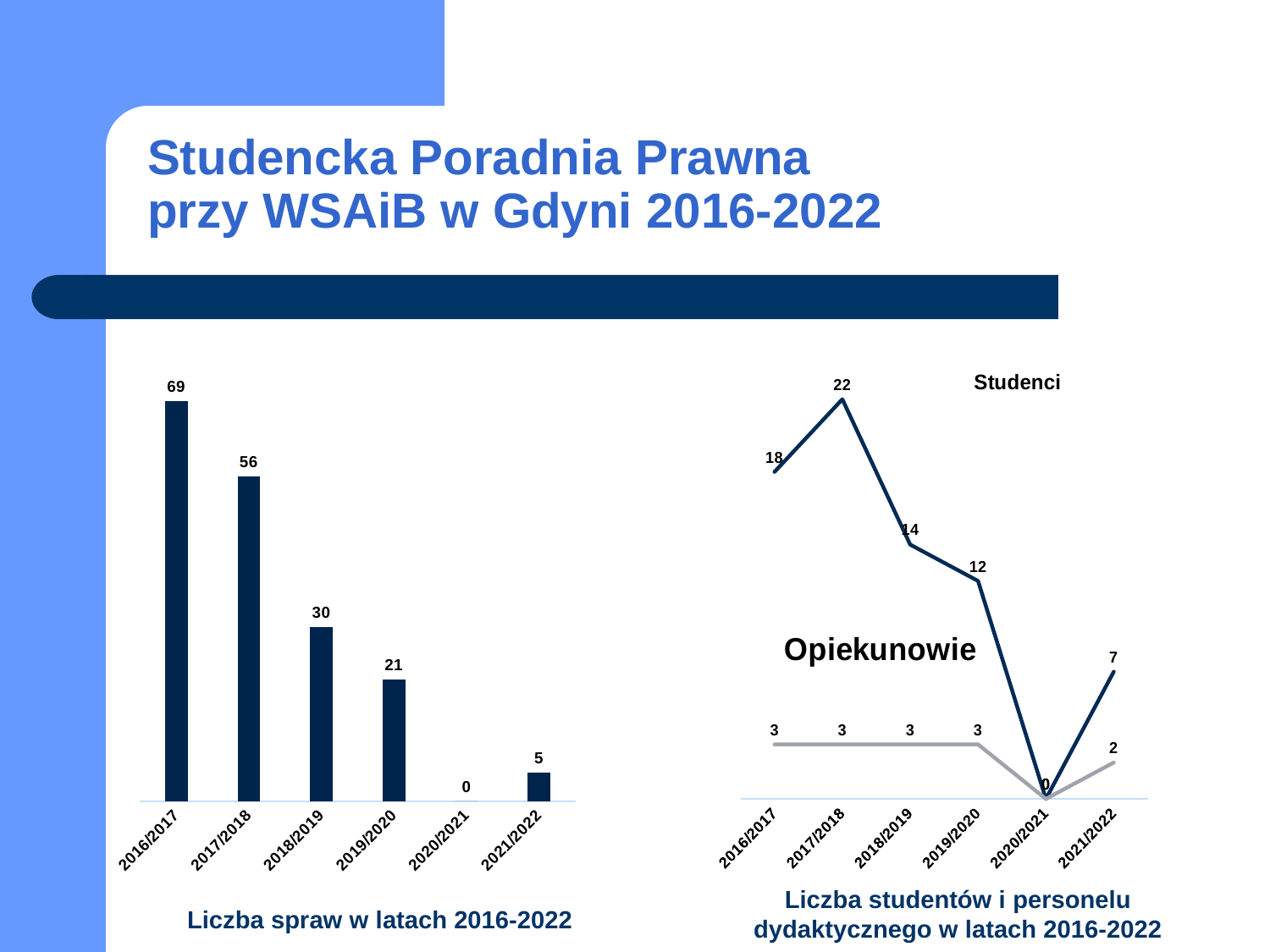
In the chart titled 'Liczba spraw w latach 2016-2022', which year has the lowest value? 2020/2021 In the chart titled 'Liczba studentów i personelu dydaktycznego w latach 2016-2022', what is the difference between the Studenci and Opiekunowie values for 2016/2017? 15 In the chart titled 'Liczba spraw w latach 2016-2022', do the values generally rise or fall from 2016/2017 to 2020/2021? fall In the chart titled 'Liczba spraw w latach 2016-2022', which year has the highest value? 2016/2017 In the chart titled 'Liczba studentów i personelu dydaktycznego w latach 2016-2022', which is larger in 2019/2020: Studenci or Opiekunowie? Studenci How many series are plotted in the chart titled 'Liczba studentów i personelu dydaktycznego w latach 2016-2022'? 2 What kind of chart is the one titled 'Liczba spraw w latach 2016-2022'? bar chart In the chart titled 'Liczba spraw w latach 2016-2022', how many years are shown on the x axis? 6 In the chart titled 'Liczba spraw w latach 2016-2022', what is the difference between the values for 2016/2017 and 2018/2019? 39 In the chart titled 'Liczba studentów i personelu dydaktycznego w latach 2016-2022', what is the Studenci value for 2017/2018? 22 In the chart titled 'Liczba studentów i personelu dydaktycznego w latach 2016-2022', what is the Opiekunowie value for 2021/2022? 2 In the chart titled 'Liczba spraw w latach 2016-2022', what is the value for 2017/2018? 56